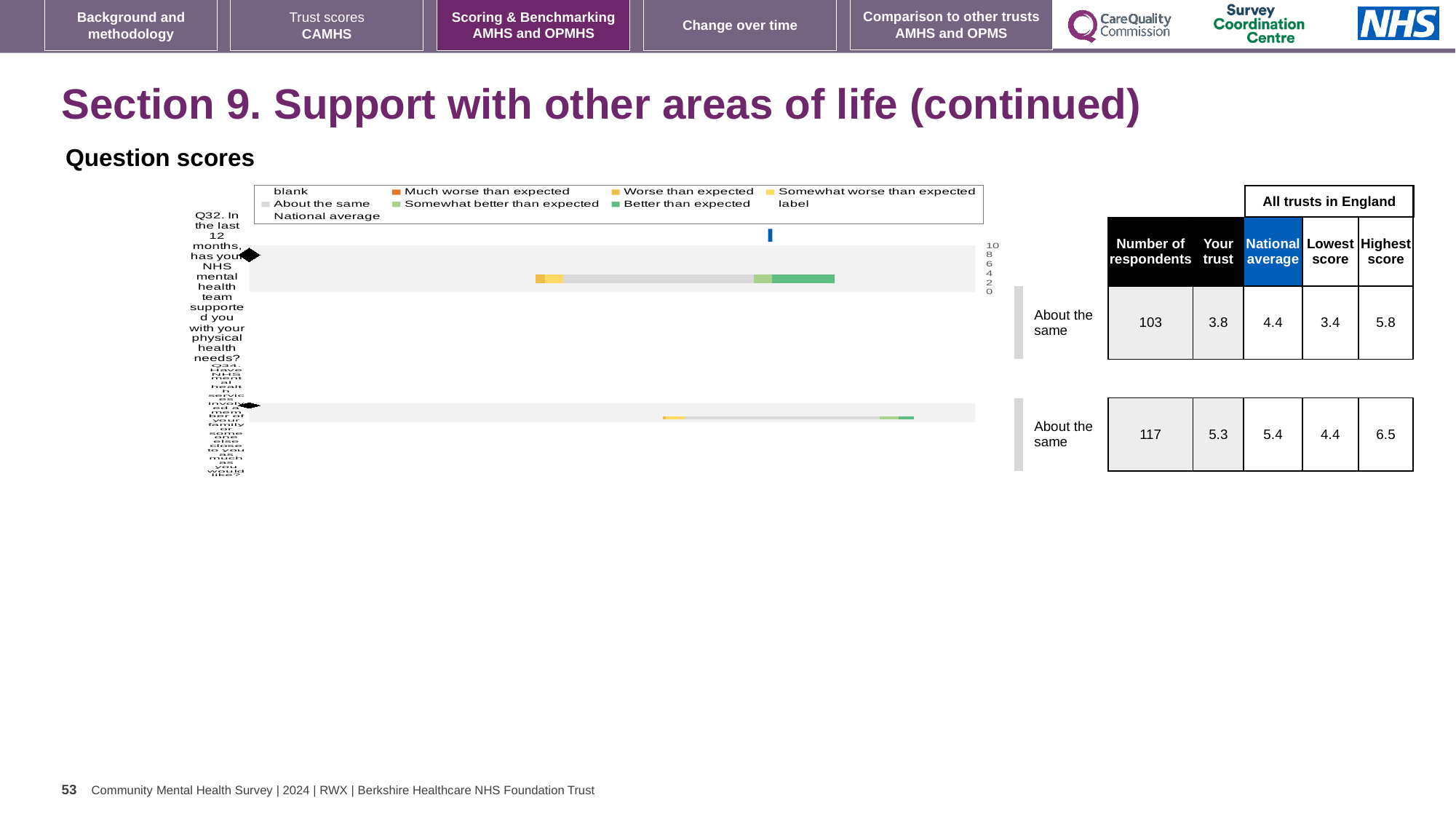
What is the highest value shown on the chart's axis? 10 In the table beside the chart, what is the highest score for Q34? 6.5 In the table beside the chart, how many respondents are listed for Q32? 103 What kind of chart is shown under 'Question scores'? bar chart In the table beside the chart, what is the national average for Q34? 5.4 What is the difference between the highest score and the lowest score for Q32? 2.4 For Q34, which is larger: the 'Your trust' score or the national average? national average What benchmark category is shown next to both Q32 and Q34? About the same Which question has more respondents, Q32 or Q34? Q34 How many questions (bars) are plotted in the chart? 2 What colour does the legend use for 'Better than expected'? green In the table beside the chart, what is the 'Your trust' score for Q32? 3.8